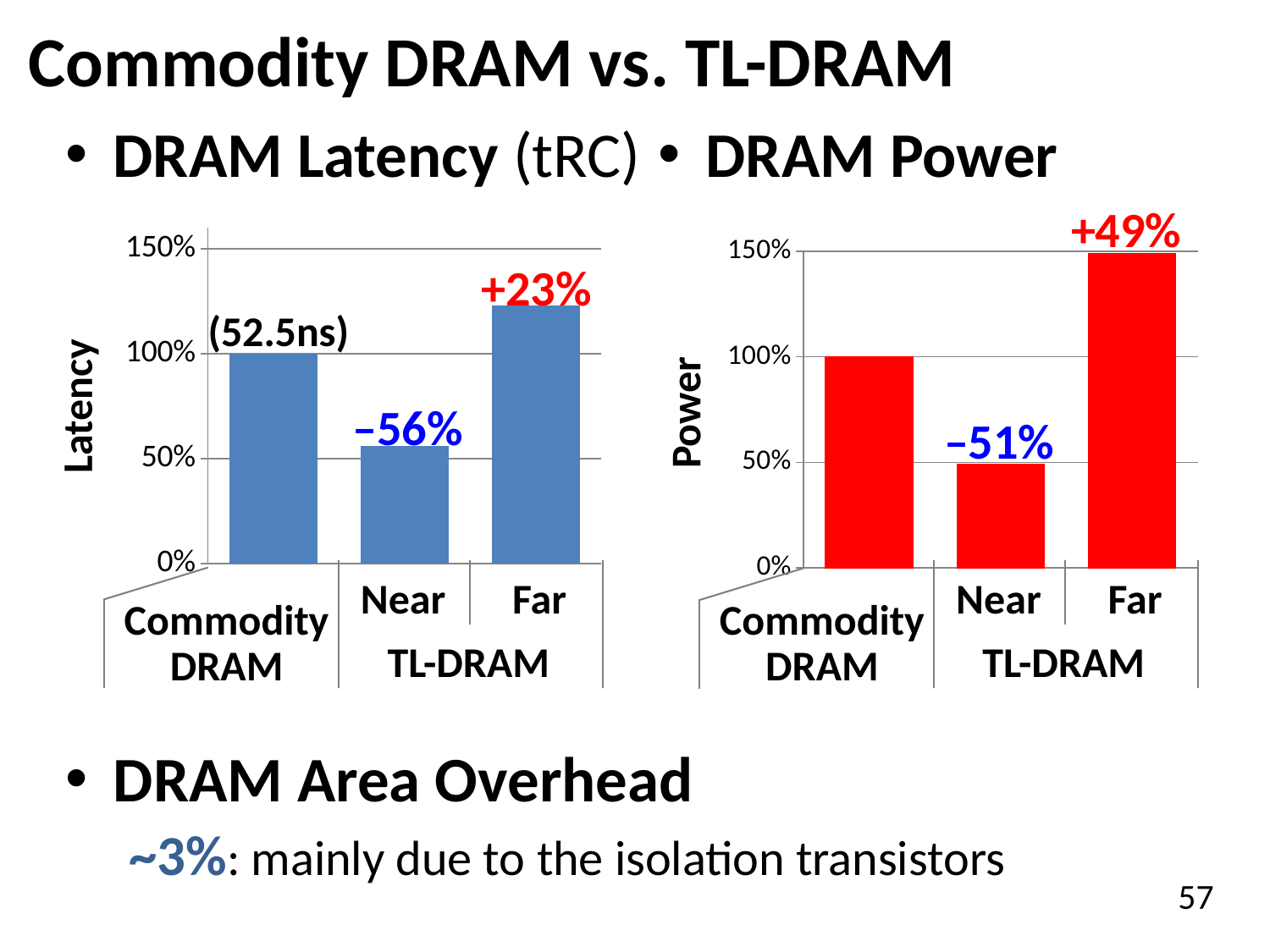
In the DRAM Latency chart, what absolute latency is given in parentheses for Commodity DRAM? 52.5ns In the DRAM Latency chart, what is the latency value of the Commodity DRAM bar? 100% In the DRAM Power chart, what colour are the bars? red In the DRAM Power chart, is the value for the Far TL-DRAM bar greater or less than 100%? greater In the DRAM Power chart, what percentage change is labelled above the Far TL-DRAM bar? +49% In the DRAM Latency chart, how many bars are plotted? 3 In the DRAM Latency chart, what percentage change is labelled above the Far TL-DRAM bar? +23% In the DRAM Latency chart, which bar is the lowest? Near In the DRAM Latency chart, what kind of chart is used? bar chart In the DRAM Power chart, what percentage change is labelled above the Near TL-DRAM bar? –51% In the DRAM Latency chart, what percentage change is labelled above the Near TL-DRAM bar? –56% In the DRAM Power chart, which bar is the highest? Far